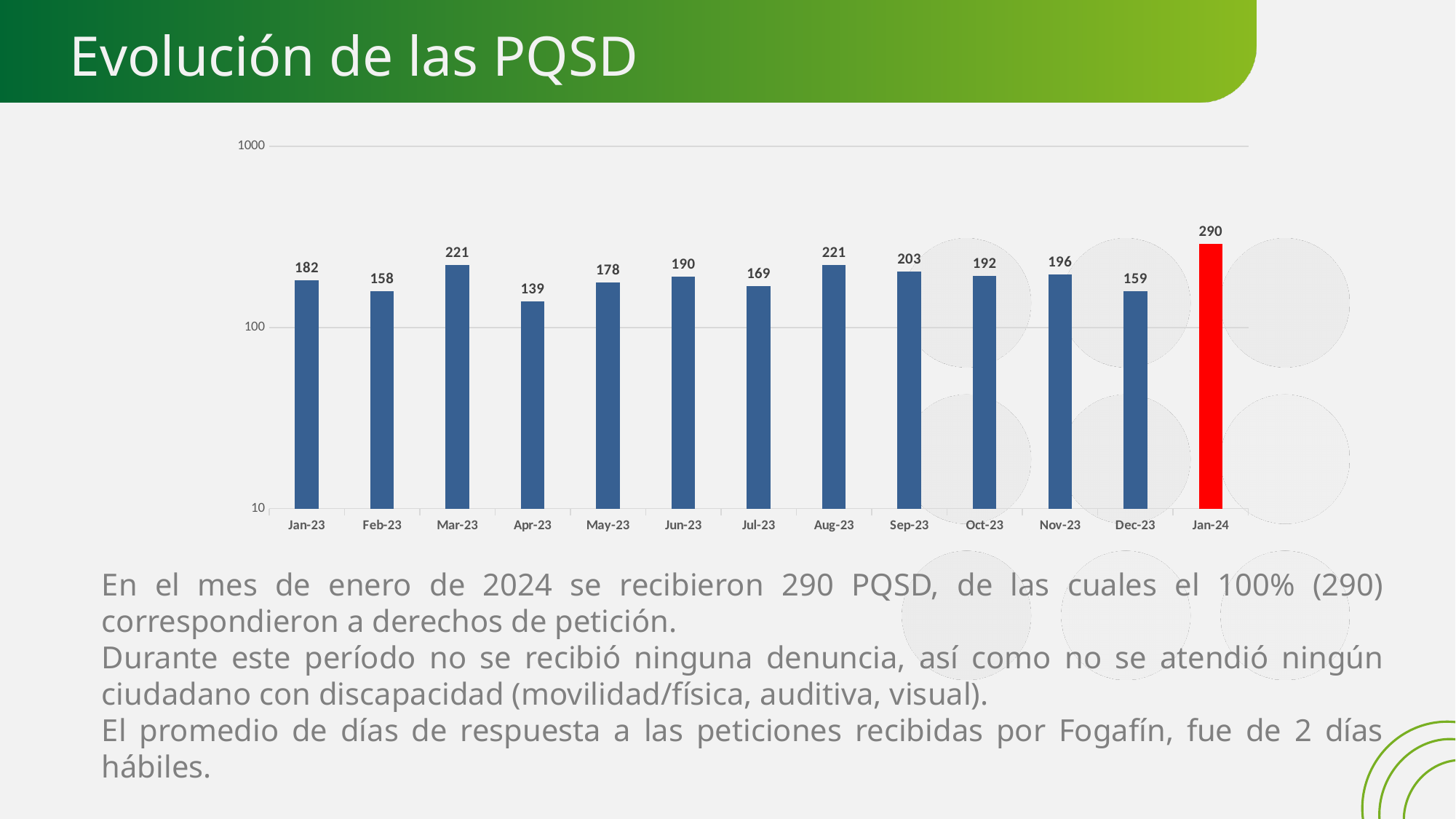
Is the value for Nov-23 greater or less than 100? greater Which month has the lowest value? Apr-23 Which bar is coloured red? Jan-24 What is the value for Sep-23? 203 What kind of chart is shown on the slide? bar chart What is the value for Apr-23? 139 What is the value for Jan-24? 290 Which is larger, the value for Jun-23 or the value for Jul-23? Jun-23 Which month has the highest value? Jan-24 How many months are shown on the x axis? 13 What is the difference between the values for Jan-24 and Dec-23? 131 What is the difference between the values for Mar-23 and Feb-23? 63